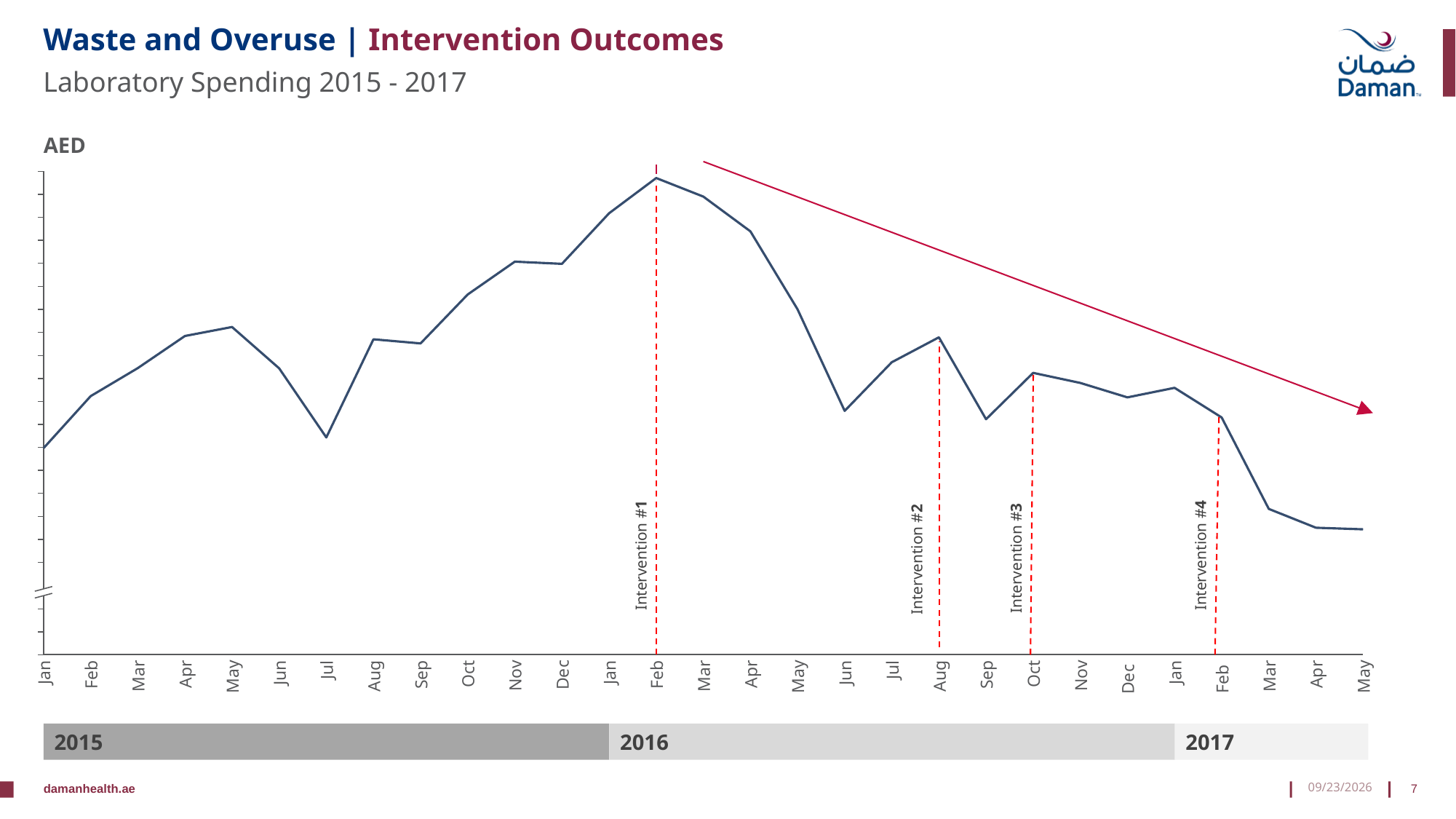
Which is higher, laboratory spending in Jul 2015 or in Aug 2015? Aug 2015 Does laboratory spending rise or fall overall from Feb 2016 to May 2017? fall What kind of chart is shown on the slide? line chart Which is higher, laboratory spending in Jan 2017 or in Mar 2017? Jan 2017 In which month and year is Intervention #1 marked? Feb 2016 Does laboratory spending rise or fall overall from Jan 2015 to Feb 2016? rise How many months are plotted on the x axis? 29 How many interventions are marked on the chart? 4 Which is higher, laboratory spending in Feb 2016 or in Feb 2017? Feb 2016 In which month and year does laboratory spending reach its highest point? Feb 2016 How many years are shown along the bottom of the chart? 3